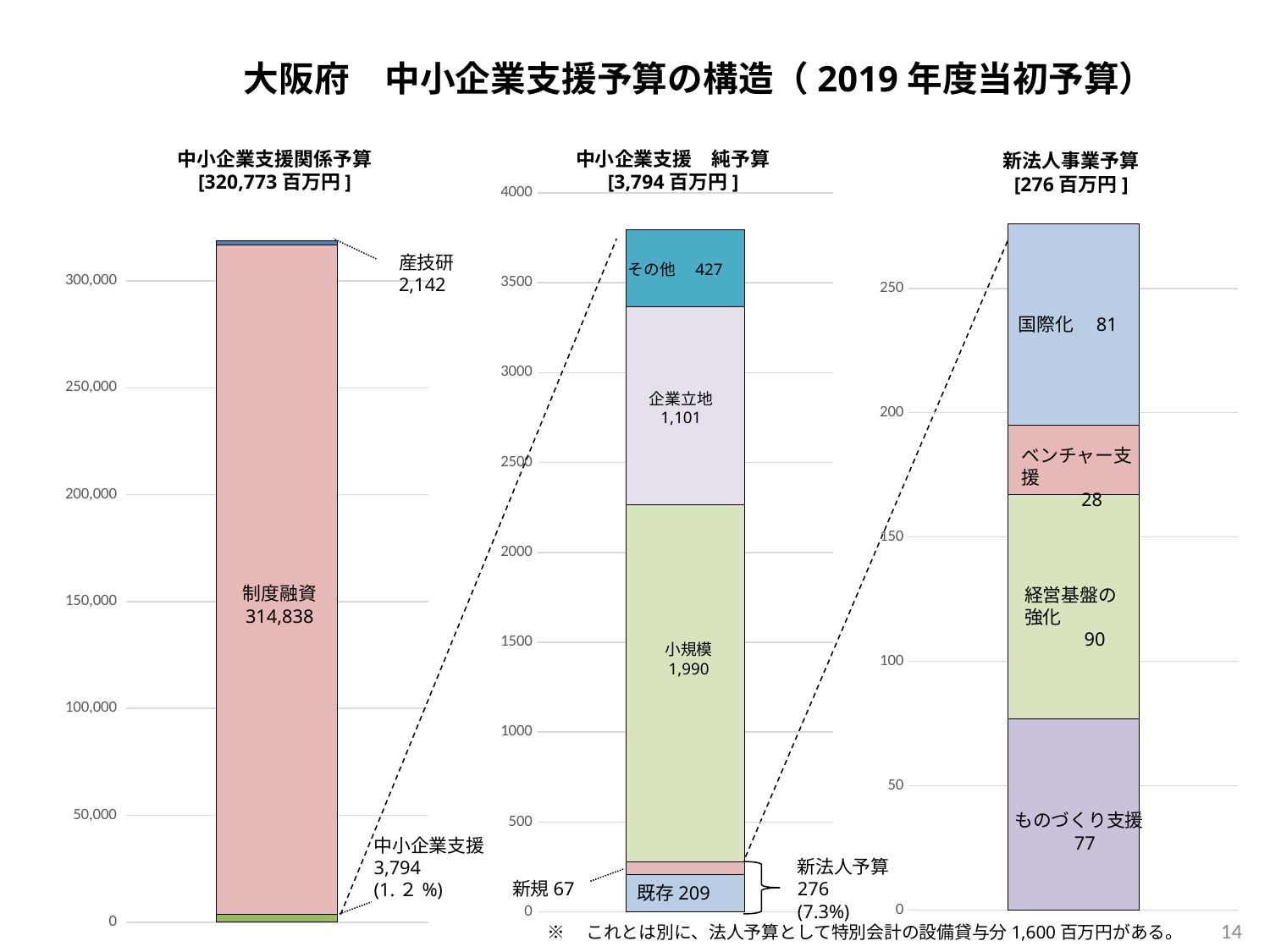
In the left chart (中小企業支援関係予算), what is the value of the 産技研 segment? 2,142 In the middle chart (中小企業支援 純予算), what is the difference between the 小規模 and 企業立地 segments? 889 In the left chart (中小企業支援関係予算), what percentage of the total does the 中小企業支援 segment represent? 1.2% In the middle chart (中小企業支援 純予算), what is the value of the 既存 segment? 209 In the middle chart (中小企業支援 純予算), how many segments make up the stacked bar? 5 In the right chart (新法人事業予算), which segment has the smallest value? ベンチャー支援 In the middle chart (中小企業支援 純予算), what is the value of the 小規模 segment? 1,990 What type of chart is used for the three charts on this slide? Stacked bar chart In the right chart (新法人事業予算), which segment has the largest value? 経営基盤の強化 In the right chart (新法人事業予算), what is the total of the stacked bar? 276 In the left chart (中小企業支援関係予算), what is the value of the 制度融資 segment? 314,838 In the right chart (新法人事業予算), which is larger, 国際化 or ものづくり支援? 国際化